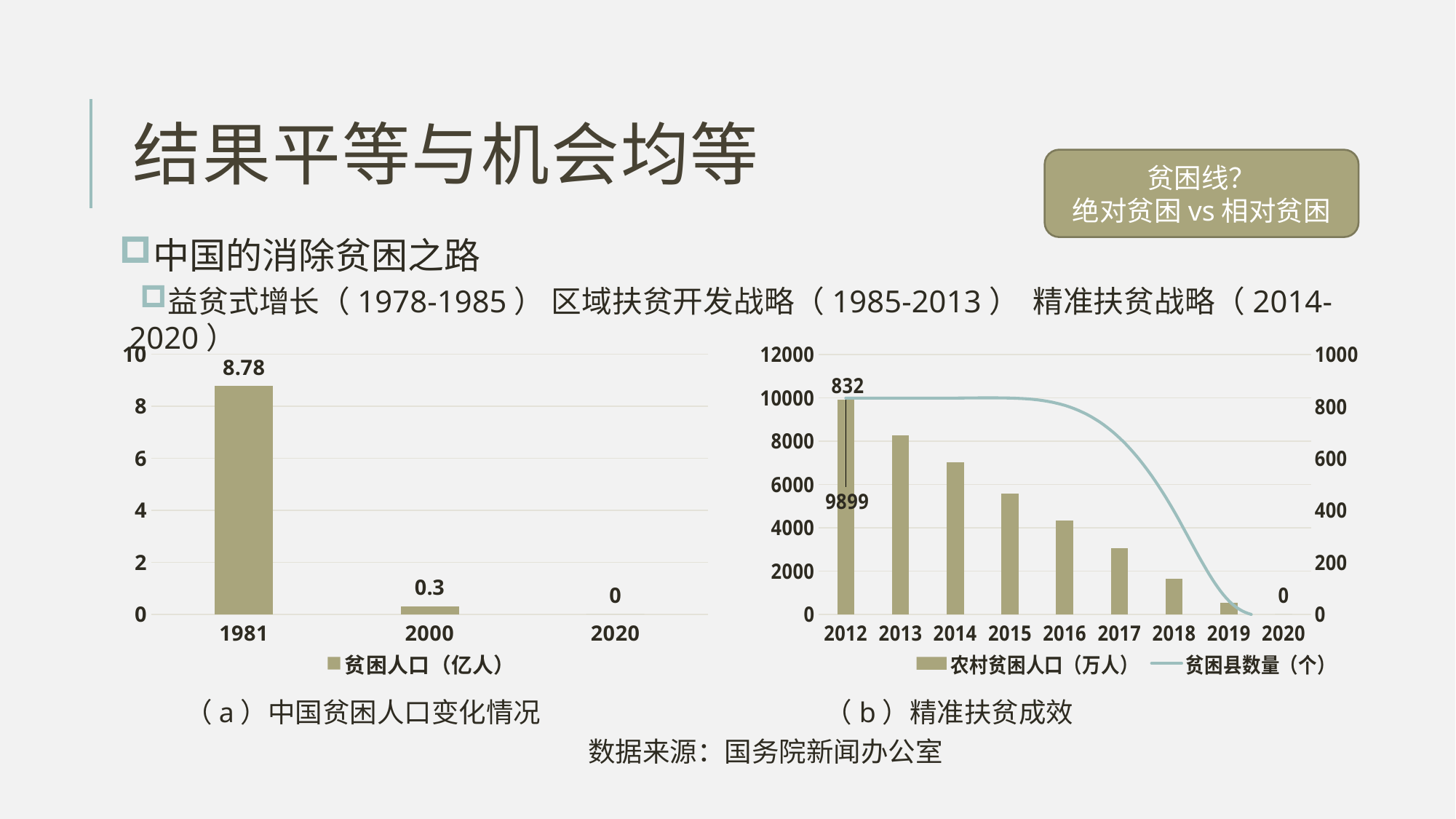
In chart (b) 精准扶贫成效, what is the value of 贫困县数量（个） for 2012? 832 In chart (b) 精准扶贫成效, do the 农村贫困人口（万人） bars rise or fall from 2012 to 2020? fall In chart (a) 中国贫困人口变化情况, how many years are shown on the x axis? 3 In chart (b) 精准扶贫成效, how many series does the legend list? 2 In chart (b) 精准扶贫成效, is the value of 农村贫困人口（万人） for 2013 greater or less than 8000? greater In chart (a) 中国贫困人口变化情况, which year has the highest value? 1981 In chart (a) 中国贫困人口变化情况, what kind of chart is it? bar chart In chart (b) 精准扶贫成效, what is the value of 农村贫困人口（万人） for 2012? 9899 In chart (a) 中国贫困人口变化情况, what is the value for 2000? 0.3 In chart (a) 中国贫困人口变化情况, what is the difference between the values for 1981 and 2000? 8.48 In chart (a) 中国贫困人口变化情况, what is the value for 1981? 8.78 In chart (b) 精准扶贫成效, is the value of 农村贫困人口（万人） for 2015 greater or less than 6000? less